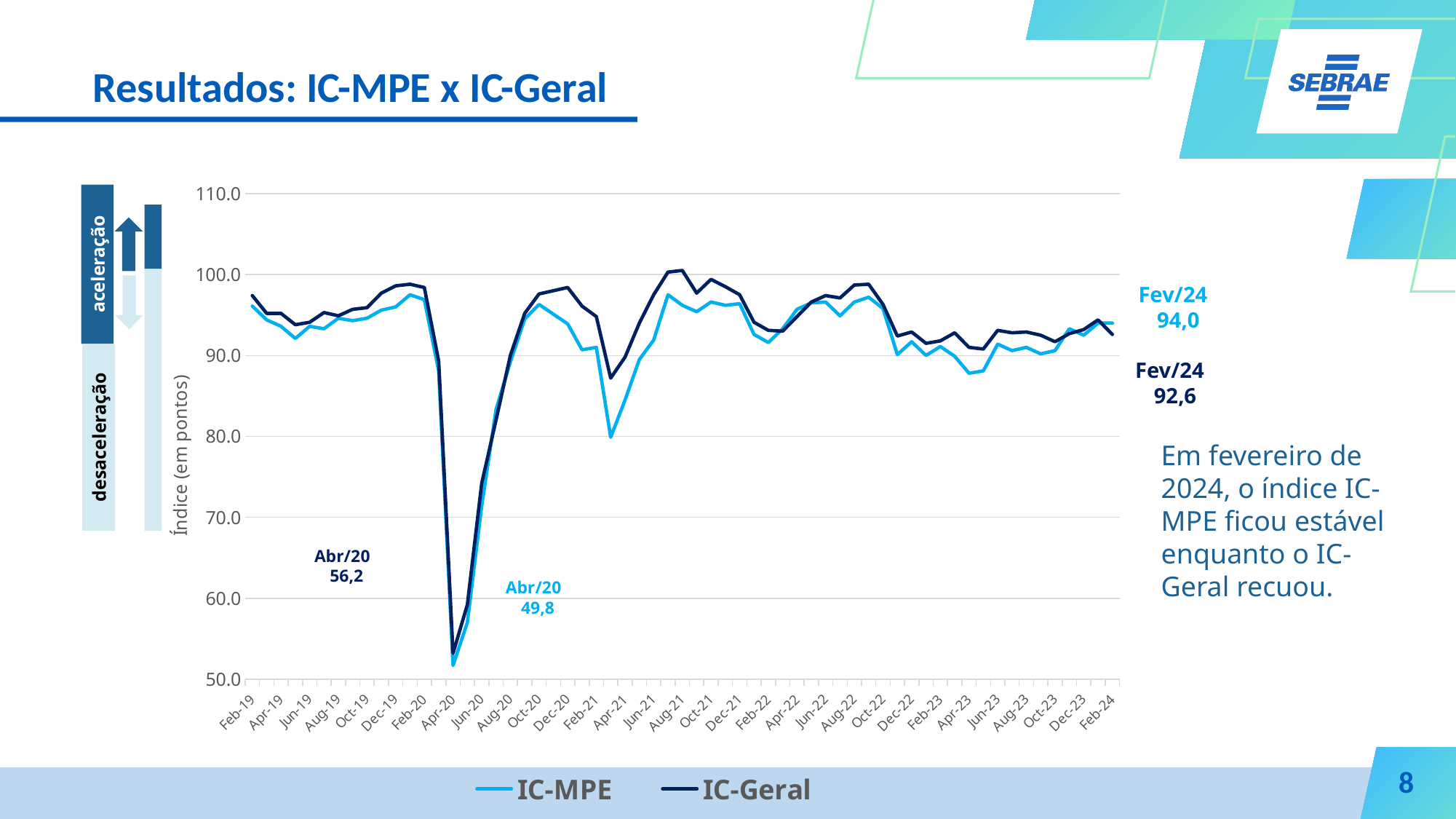
Which series has the higher value in Abr/20, IC-MPE or IC-Geral? IC-Geral Is the value of IC-MPE in Apr-21 greater or less than 90.0? less What is the value of IC-MPE in Fev/24? 94,0 What is the difference between IC-Geral and IC-MPE in Abr/20? 6,4 What is the value of IC-Geral in Fev/24? 92,6 How many series does the legend list? 2 What is the value of IC-MPE in Abr/20? 49,8 In which month does the IC-MPE series reach its lowest value? Abr/20 What kind of chart is shown on the slide? Line chart What is the value of IC-Geral in Abr/20? 56,2 What is the difference between IC-MPE and IC-Geral in Fev/24? 1,4 Which series has the higher value in Fev/24, IC-MPE or IC-Geral? IC-MPE